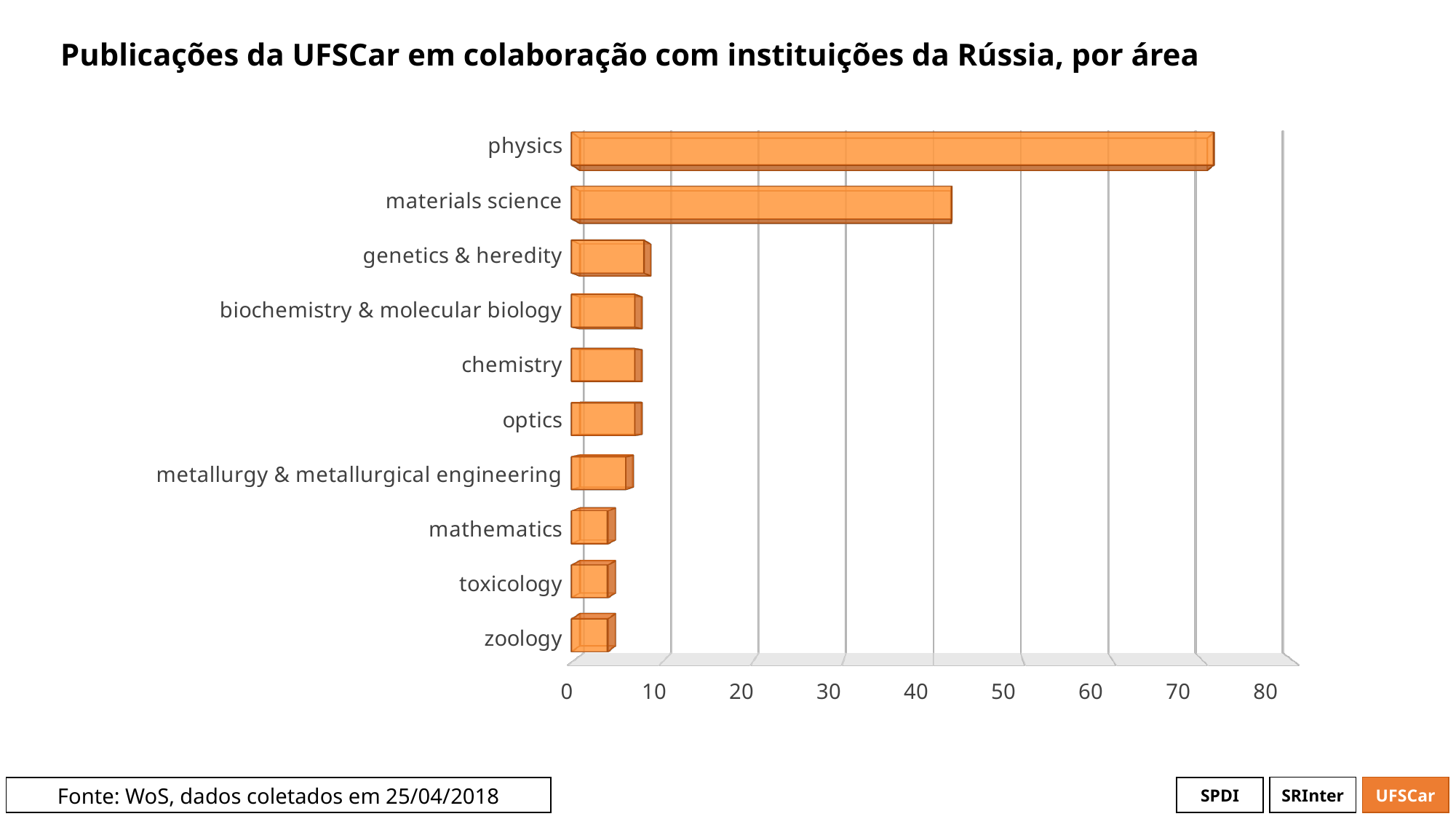
Is the value for materials science greater or less than 50? less Which has more publications, physics or materials science? physics How many areas (categories) are shown in the chart? 10 What is the title of the chart? Publicações da UFSCar em colaboração com instituições da Rússia, por área Which area has the highest number of publications? physics Is the value for mathematics greater or less than 10? less Is the value for physics greater or less than 70? greater Which has more publications, materials science or chemistry? materials science Which has more publications, genetics & heredity or zoology? genetics & heredity What kind of chart is shown on the slide? bar chart